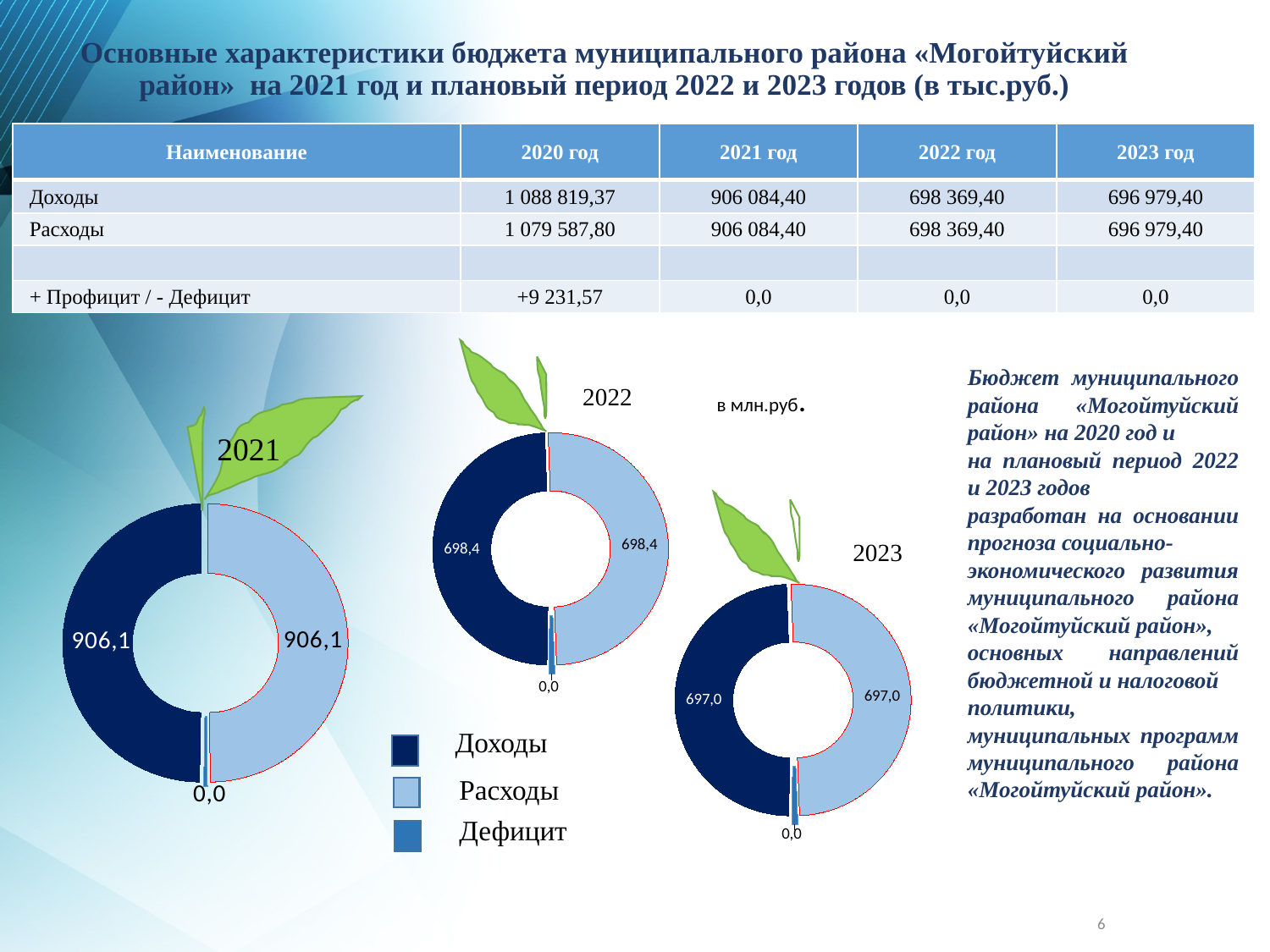
In the 2023 chart, what is the value for Дефицит? 0,0 In what units are the values in the doughnut charts given, according to the label next to the 2022 chart? в млн.руб. What kind of chart is the 2021 chart on the slide? Doughnut chart In the 2021 chart, what is the value for Дефицит? 0,0 In the 2022 chart, what is the difference between Доходы and Расходы? 0,0 How many doughnut charts are shown on the slide? 3 In the 2022 chart, what is the value for Дефицит? 0,0 In the 2021 chart, what is the value for Расходы? 906,1 In the 2021 chart, what is the value for Доходы? 906,1 In the 2023 chart, what is the value for Расходы? 697,0 In the 2022 chart, what is the value for Доходы? 698,4 How many entries does the legend shared by the doughnut charts list? 3